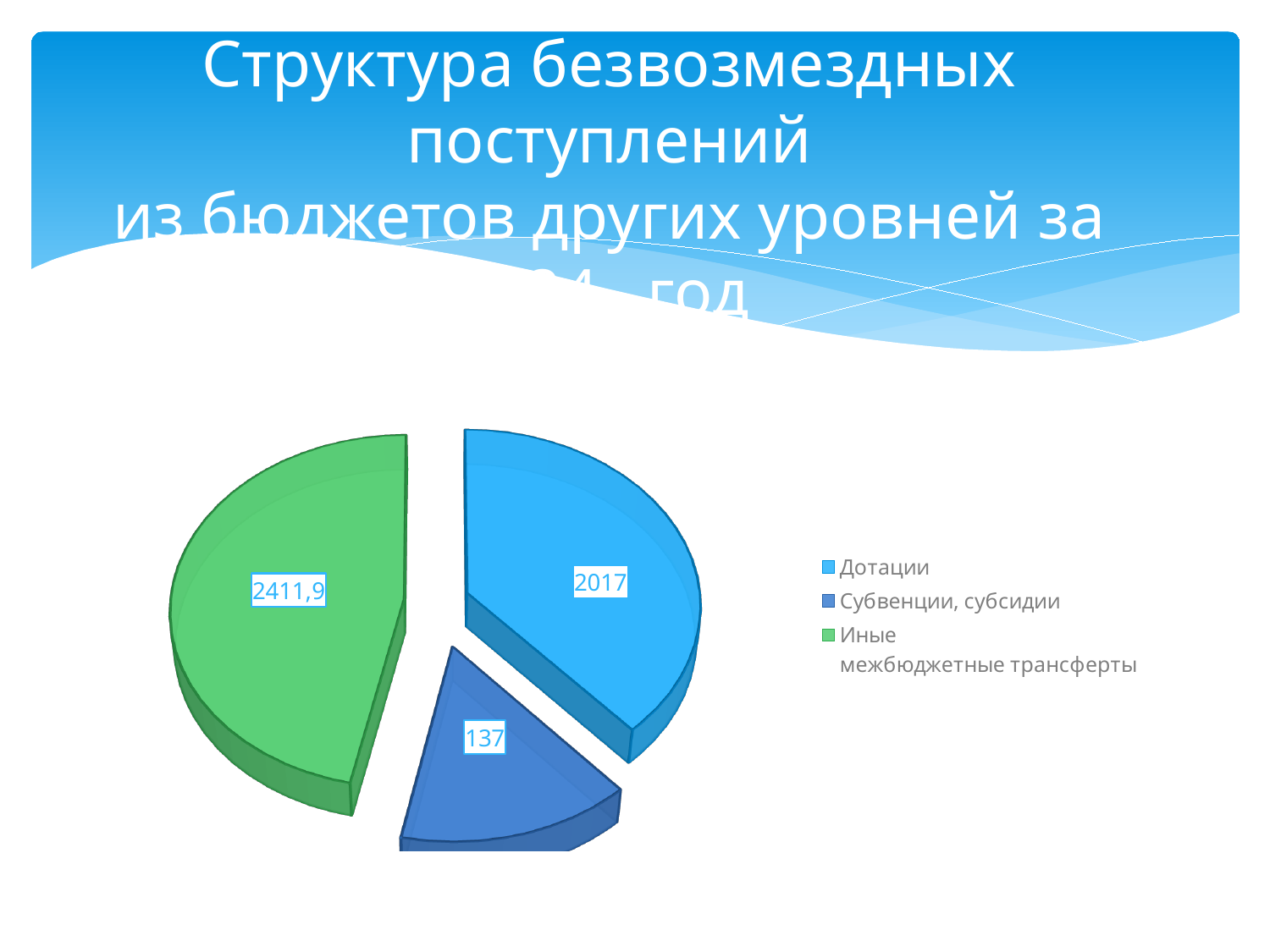
What is the value for Дотации? 2017 What is the value for Иные межбюджетные трансферты? 2411,9 How many slices does the pie chart have? 3 What type of chart is shown on the slide? pie chart What is the value for Субвенции, субсидии? 137 Which category has the smallest slice of the pie? Субвенции, субсидии Which is larger, the value for Дотации or the value for Субвенции, субсидии? Дотации What is the difference between the values for Иные межбюджетные трансферты and Дотации? 394,9 What colour is the slice for Иные межбюджетные трансферты? green What is the difference between the values for Дотации and Субвенции, субсидии? 1880 How many entries does the legend list? 3 Which category has the largest slice of the pie? Иные межбюджетные трансферты